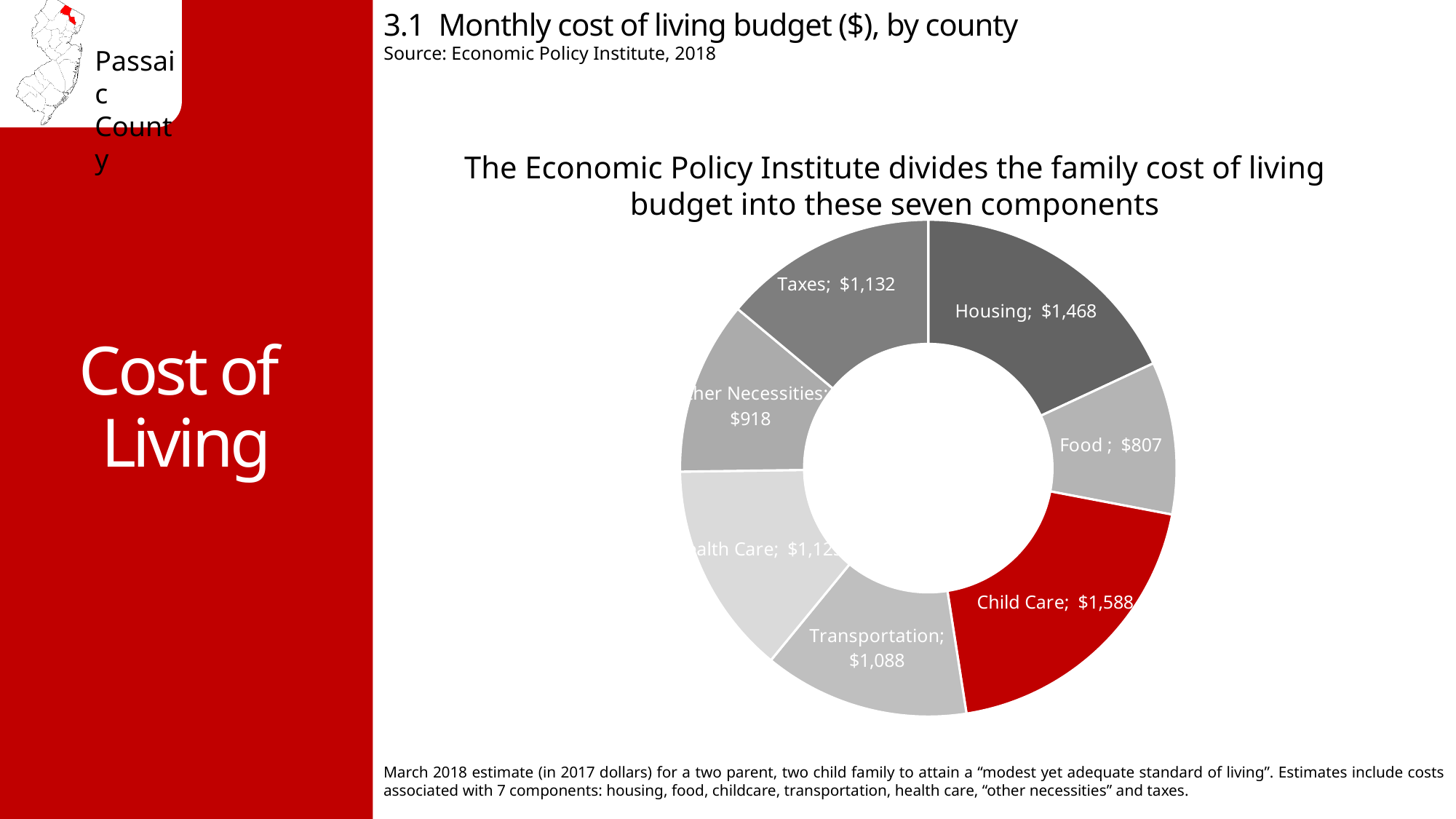
How much more is the monthly cost for Child Care than for Housing? $120 What is the monthly cost for Child Care shown on the chart? $1,588 What is the monthly cost for Other Necessities shown on the chart? $918 What is the monthly cost for Transportation shown on the chart? $1,088 What is the difference between the monthly cost for Housing and for Taxes? $336 Which component has the highest monthly cost on the chart? Child Care What is the monthly cost for Housing shown on the chart? $1,468 How many components are shown as slices in the chart? 7 What is the monthly cost for Taxes shown on the chart? $1,132 Which component has the lowest monthly cost on the chart? Food Which component's slice is coloured red in the chart? Child Care Which is larger, the monthly cost for Transportation or for Food? Transportation